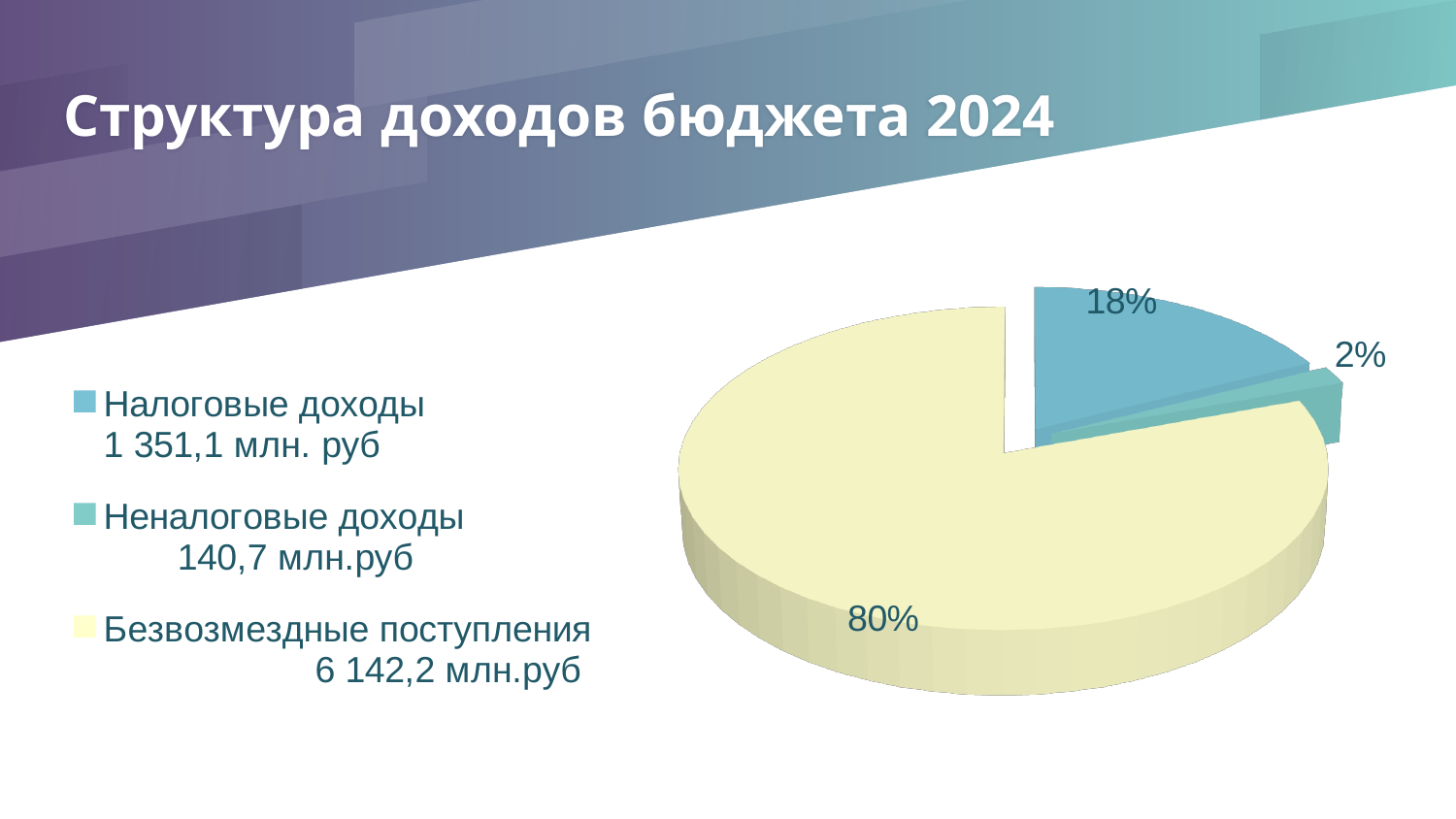
What is the title of the chart on the slide? Структура доходов бюджета 2024 How many slices does the pie chart have? 3 Which category has the largest slice of the pie? Безвозмездные поступления What value is given in the legend for "Налоговые доходы"? 1 351,1 млн. руб What value is given in the legend for "Неналоговые доходы"? 140,7 млн.руб What value is given in the legend for "Безвозмездные поступления"? 6 142,2 млн.руб What share of the pie does "Неналоговые доходы" represent? 2% Which category has the smallest slice of the pie? Неналоговые доходы What share of the pie does "Налоговые доходы" represent? 18% What kind of chart is shown on the slide? Pie chart Which is larger, the share for "Налоговые доходы" or the share for "Неналоговые доходы"? Налоговые доходы What share of the pie does "Безвозмездные поступления" represent? 80%